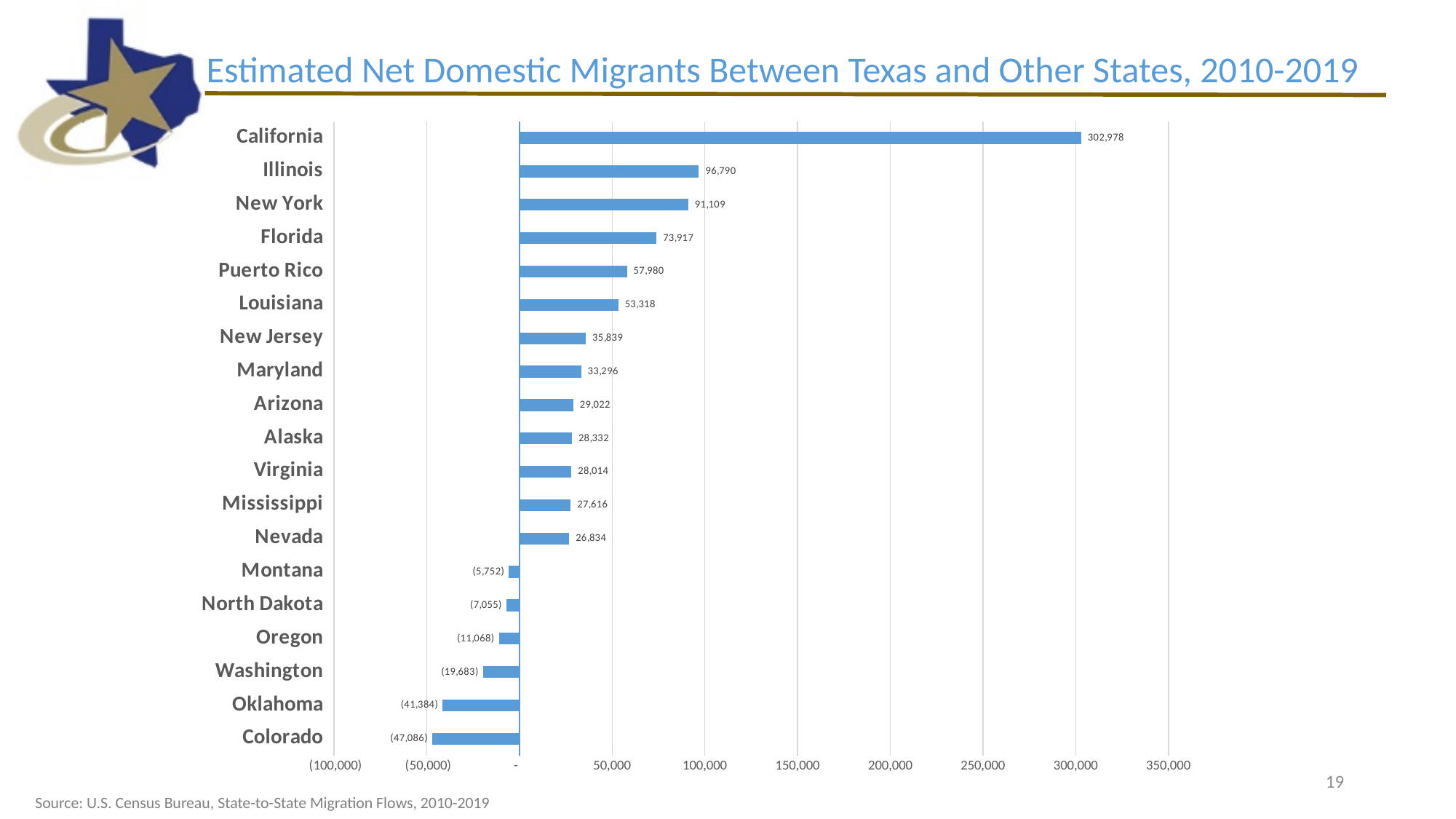
What is the title of the chart? Estimated Net Domestic Migrants Between Texas and Other States, 2010-2019 Which has a larger value, Florida or Puerto Rico? Florida Is the value for Louisiana greater or less than 50,000? greater What value is shown for Colorado? (47,086) What is the value shown for Illinois? 96,790 Which state has the lowest (most negative) value on the chart? Colorado What is the difference between the values for Illinois and New York? 5,681 Which state has the highest net domestic migration to Texas? California How many categories on the chart have negative values? 6 What is the estimated net domestic migration value for California? 302,978 How many states or territories are shown on the chart? 19 What kind of chart is shown on the slide? Bar chart